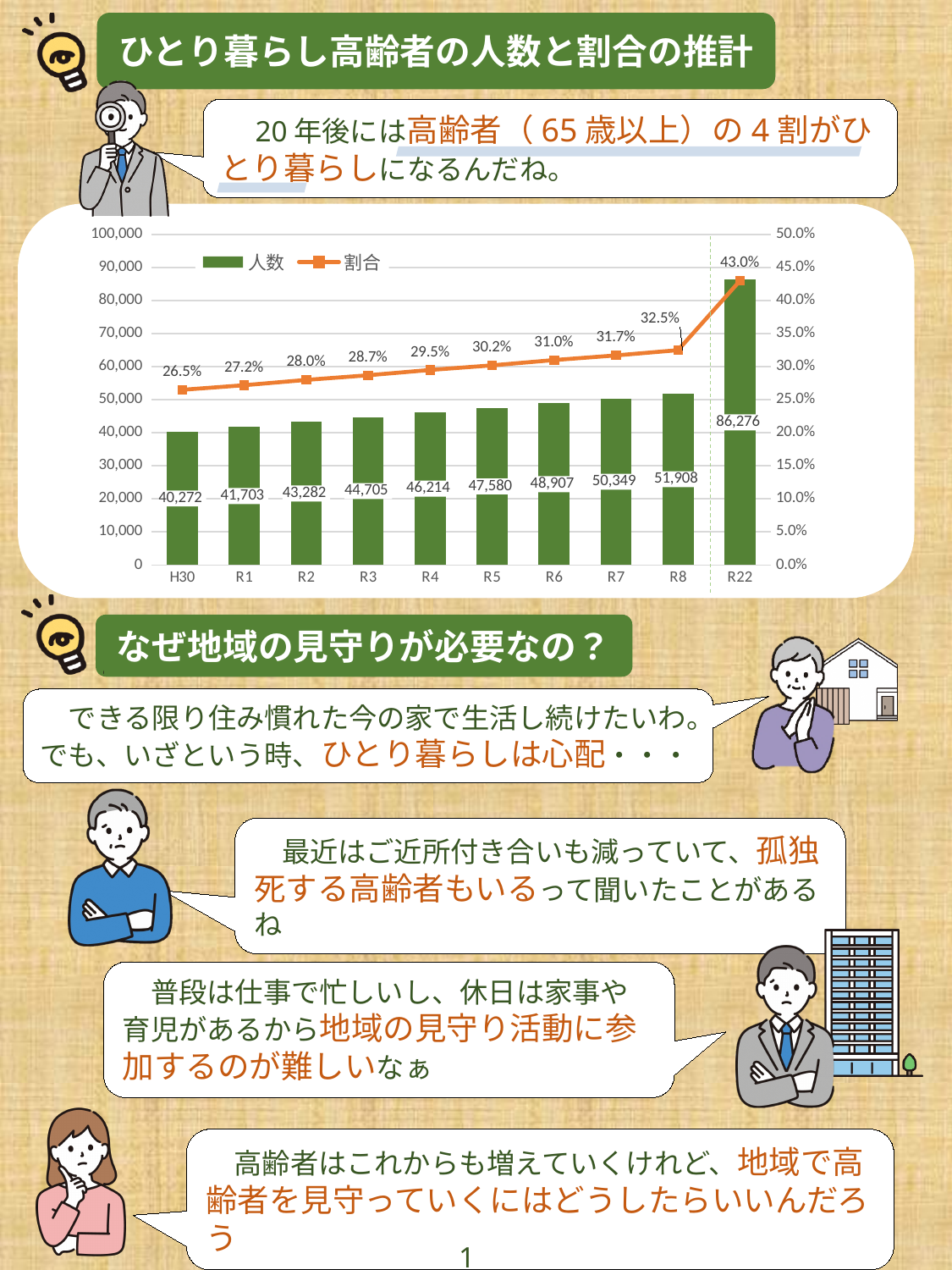
What is the 割合 value for R8? 32.5% How many categories are shown on the x axis? 10 Which has a larger 人数 value, R2 or R6? R6 What is the 人数 value for R22? 86,276 What is the difference in 人数 between R22 and R8? 34,368 Which category has the highest 人数 value? R22 How many series does the legend list? 2 What is the 人数 value for R4? 46,214 What is the 割合 value for H30? 26.5% Which category has the lowest 割合 value? H30 Does the 割合 line rise or fall from H30 to R22? rise What are the two series names listed in the legend? 人数 and 割合